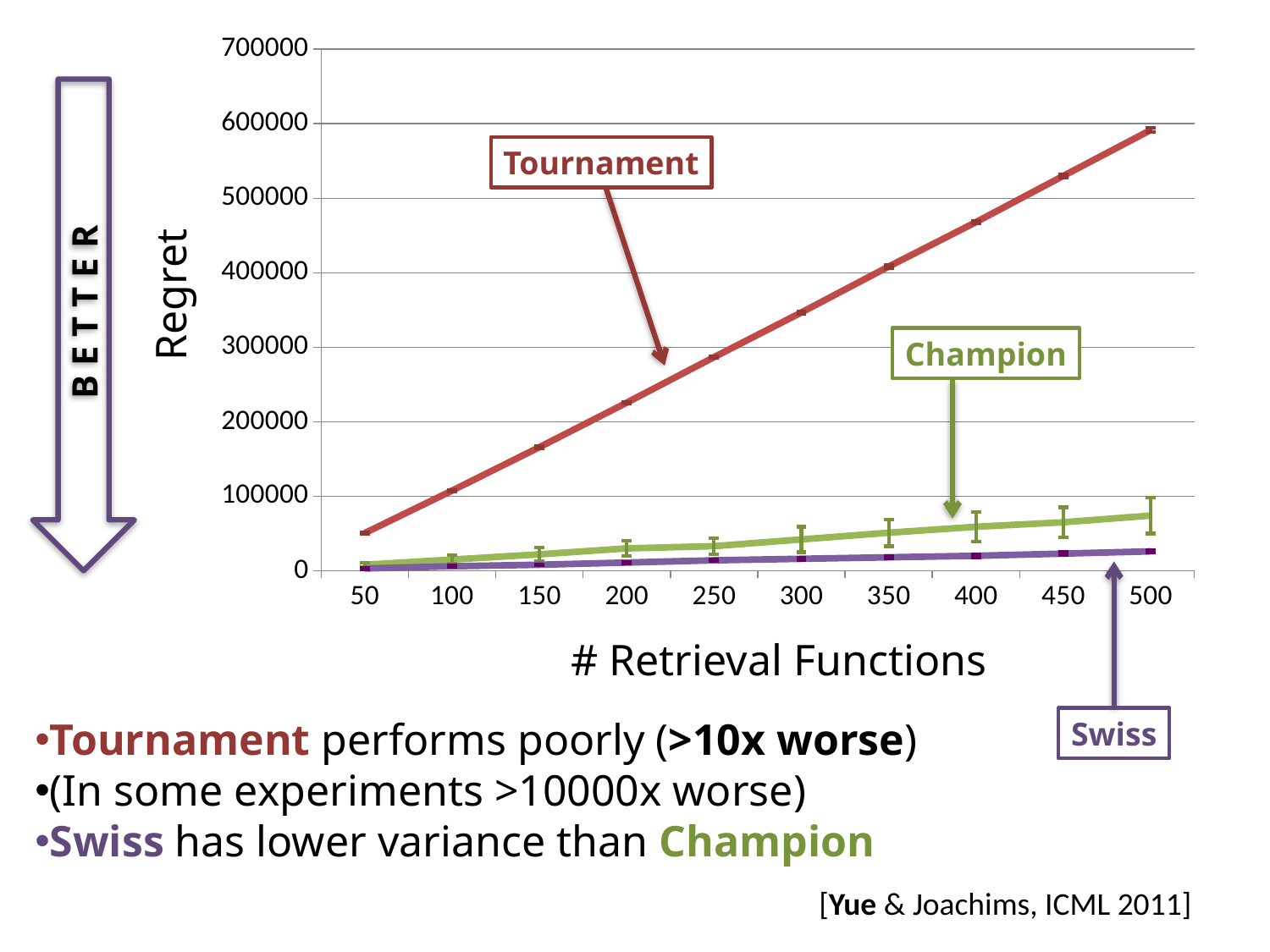
Is the regret for Tournament at 500 retrieval functions greater or less than 500000? greater Is the regret for Tournament at 250 retrieval functions greater or less than 300000? less Is the regret for Champion at 500 retrieval functions greater or less than 100000? less What kind of chart is shown on the slide? line chart How many points along the x axis (# Retrieval Functions) are plotted for each series? 10 Which series has the lowest regret at 500 retrieval functions? Swiss Which series has the highest regret at 500 retrieval functions? Tournament What is the label of the y axis? Regret Does the regret for Tournament rise or fall as the number of retrieval functions increases? rise How many series are plotted on the chart? 3 At 500 retrieval functions, which has the larger regret, Champion or Swiss? Champion